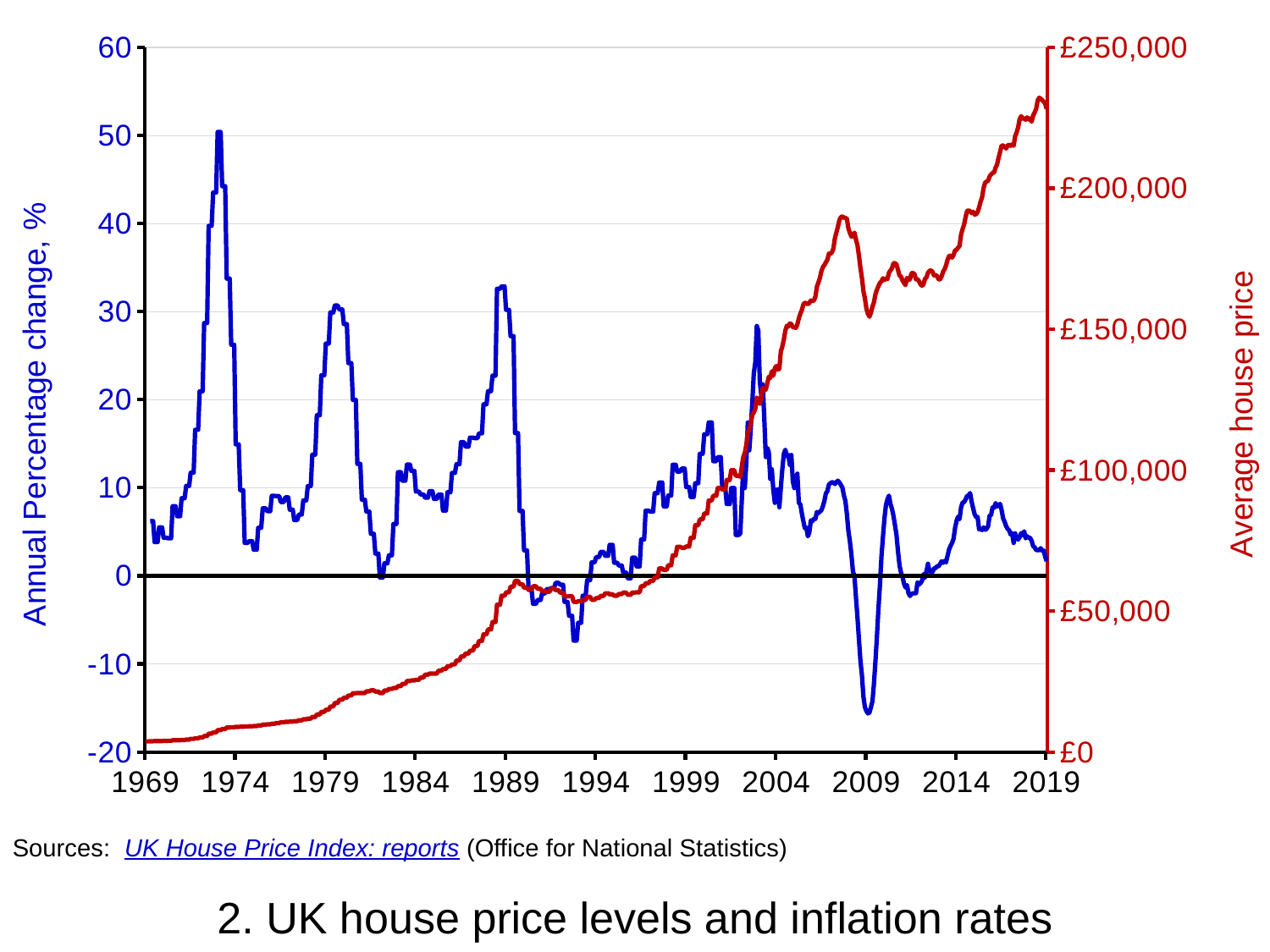
How many data series (lines) are plotted on the chart? 2 Is the highest peak of the annual percentage change (blue line), in the early 1970s, greater or less than 40%? greater Is the average house price (red line) in 2004 greater or less than £100,000? greater Does the average house price (red line) generally rise or fall from 1969 to 2019? rise In which decade does the annual percentage change (blue line) reach its highest value? 1970s Is the average house price (red line) in 2019 greater or less than £200,000? greater What is the title of the chart on the slide? 2. UK house price levels and inflation rates What kind of chart is shown on the slide? line chart Is the average house price (red line) higher in 2019 or in 2009? 2019 What is the label of the right-hand vertical axis? Average house price